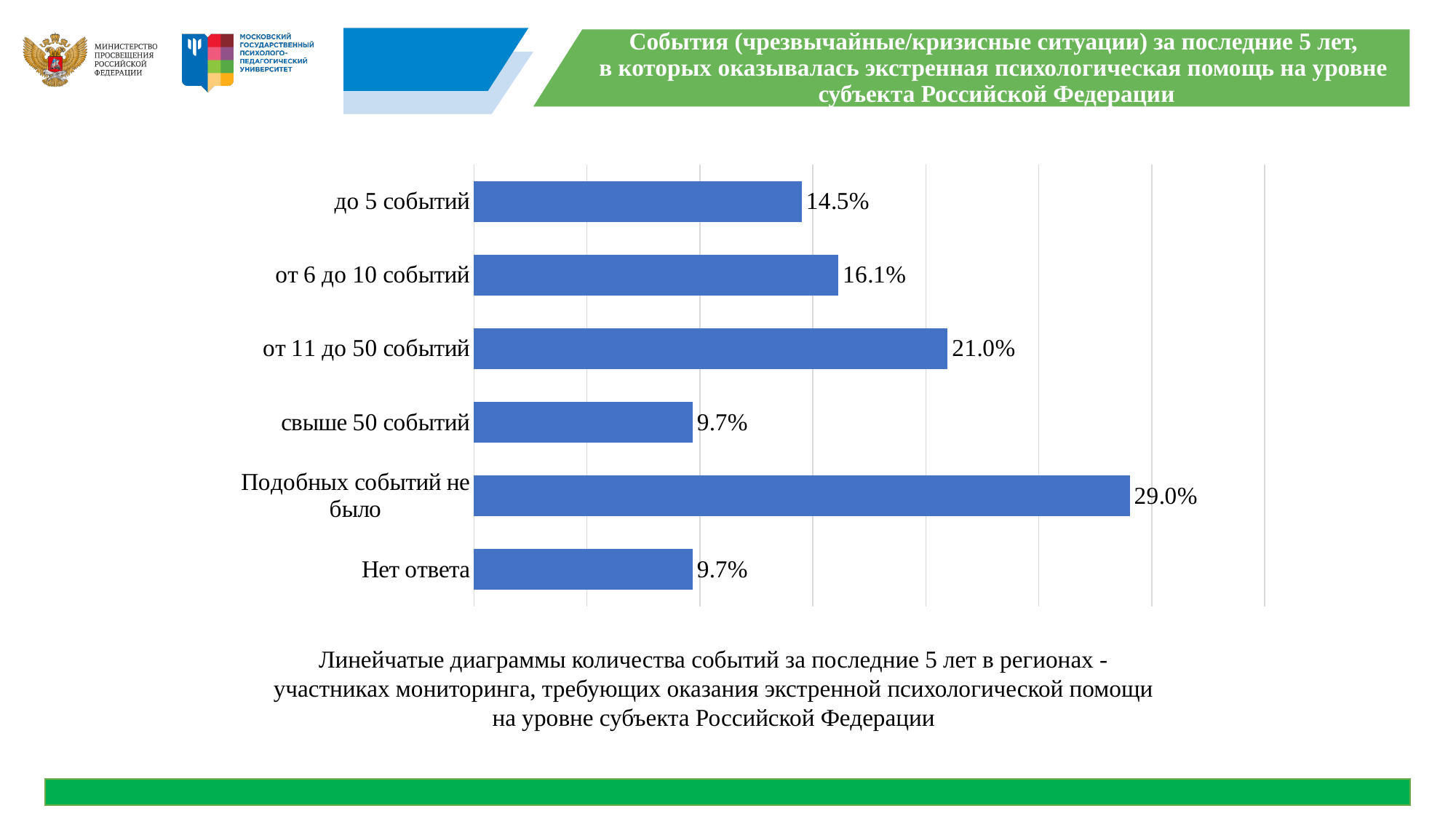
What is the value for "от 11 до 50 событий"? 21.0% What is the value for "Нет ответа"? 9.7% What colour are the bars in the chart? blue Which is larger, the value for "от 6 до 10 событий" or the value for "свыше 50 событий"? от 6 до 10 событий What is the difference between the values for "от 6 до 10 событий" and "до 5 событий"? 1.6% What is the value for "Подобных событий не было"? 29.0% What kind of chart is shown on the slide? bar chart Which two categories share the same value of 9.7%? свыше 50 событий and Нет ответа How many categories are shown in the chart? 6 Which category has the highest value? Подобных событий не было What is the value for "до 5 событий"? 14.5% What is the difference between the values for "Подобных событий не было" and "от 11 до 50 событий"? 8.0%